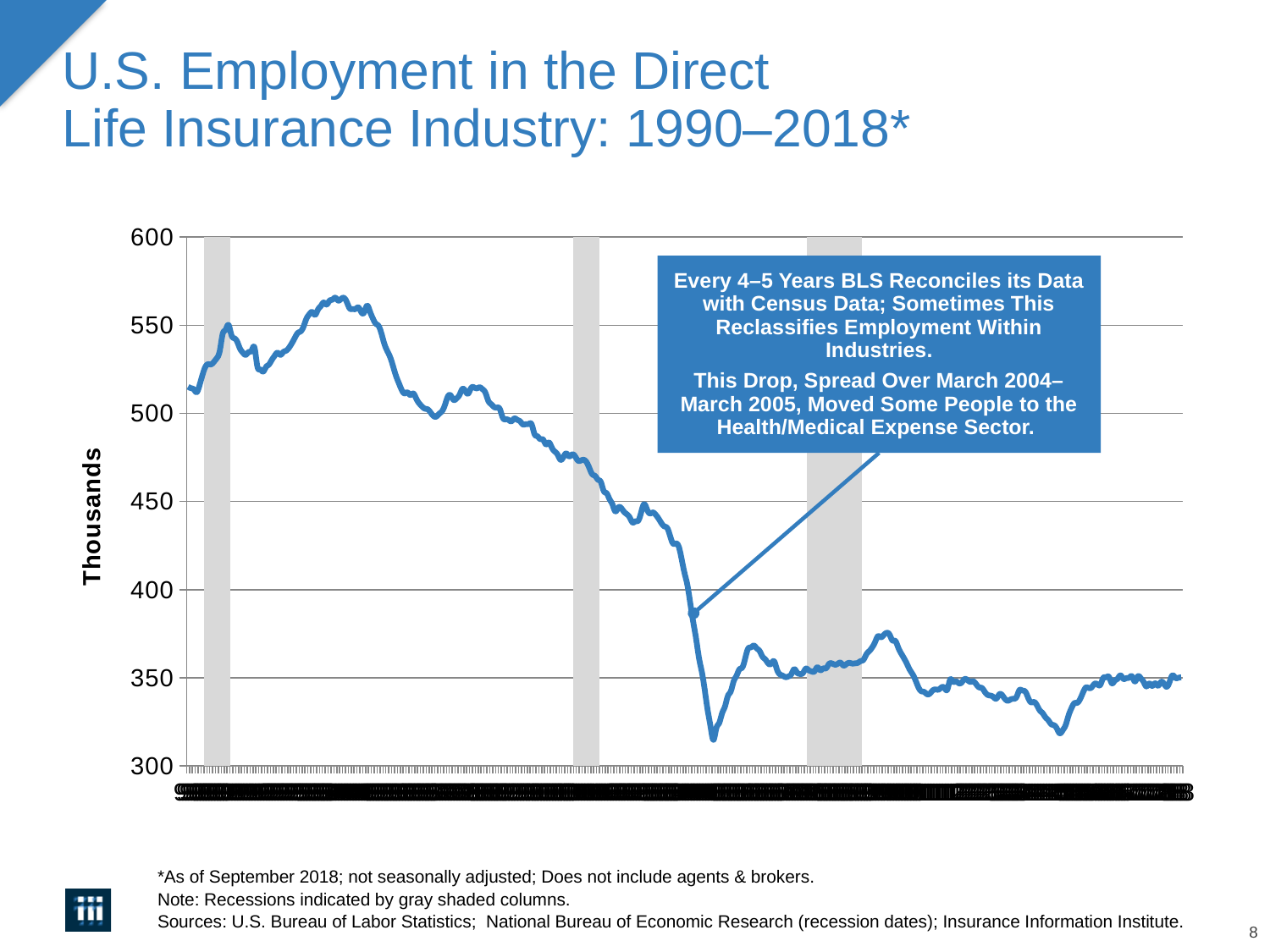
Is the value at the end of the series (September 2018) greater or less than 300? greater Is the highest value reached by the line greater or less than 550? greater Overall, does U.S. employment in the direct life insurance industry rise or fall from 1990 to 2018 along the x axis? fall Is the value at the end of the series (September 2018) greater or less than 400? less How many gray shaded recession columns appear on the chart? 3 What is the label on the vertical axis of the chart? Thousands What kind of chart is shown on the slide? line chart